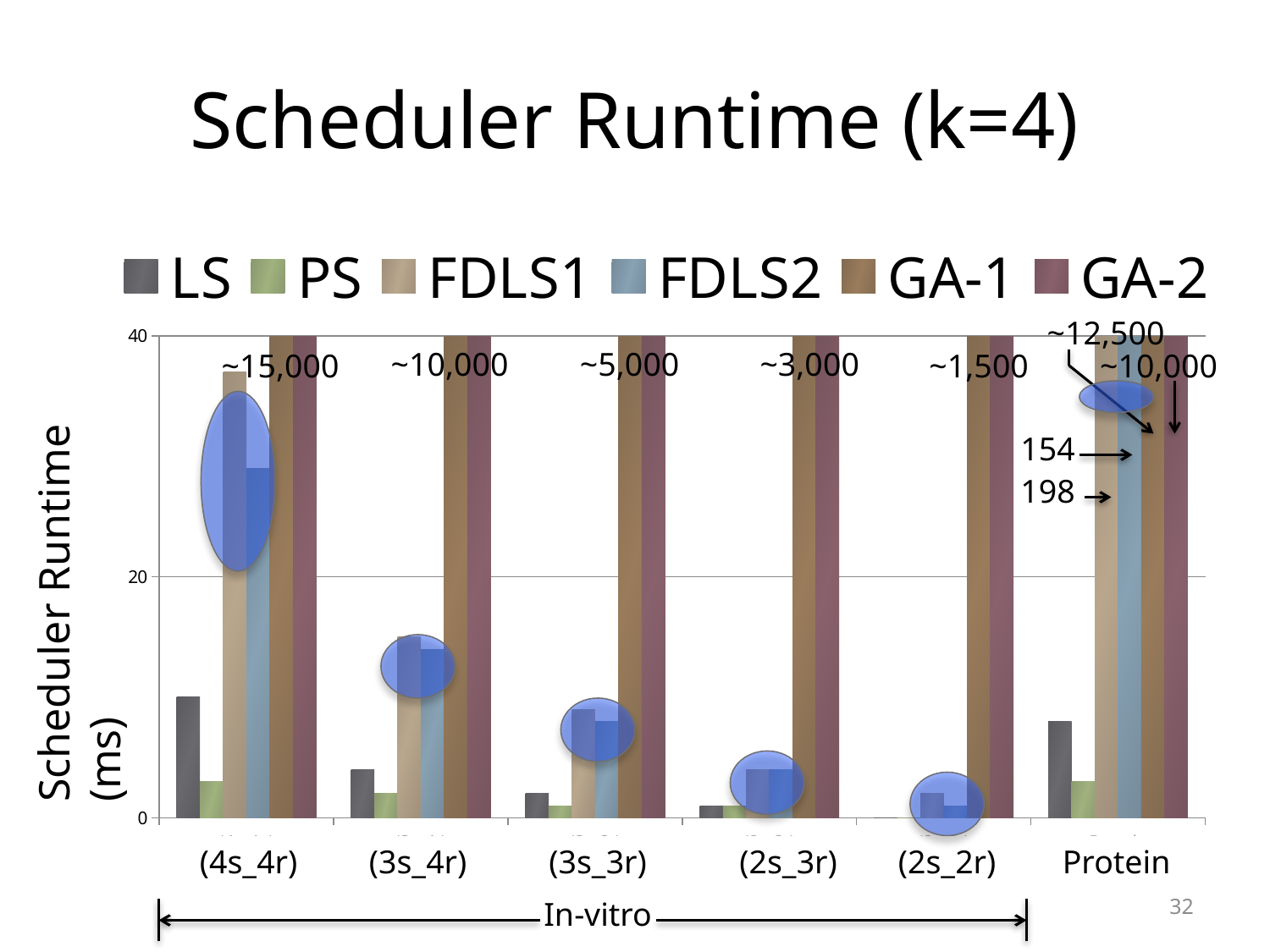
Is the GA-1 value for (4s_4r) greater or less than 20? greater How many categories are shown along the x axis? 6 How many series does the legend list? 6 Which is larger for Protein, the LS value or the PS value? LS What kind of chart is shown on the slide? bar chart Do the LS values rise or fall from (4s_4r) to (2s_2r)? fall Which is larger for (4s_4r), the LS value or the PS value? LS Is the LS value for (4s_4r) greater or less than 20? less What is the title of the chart? Scheduler Runtime (k=4) Among the in-vitro categories, which has the highest LS value? (4s_4r) Is the PS value for (3s_3r) greater or less than 20? less What is the label of the vertical axis? Scheduler Runtime (ms)